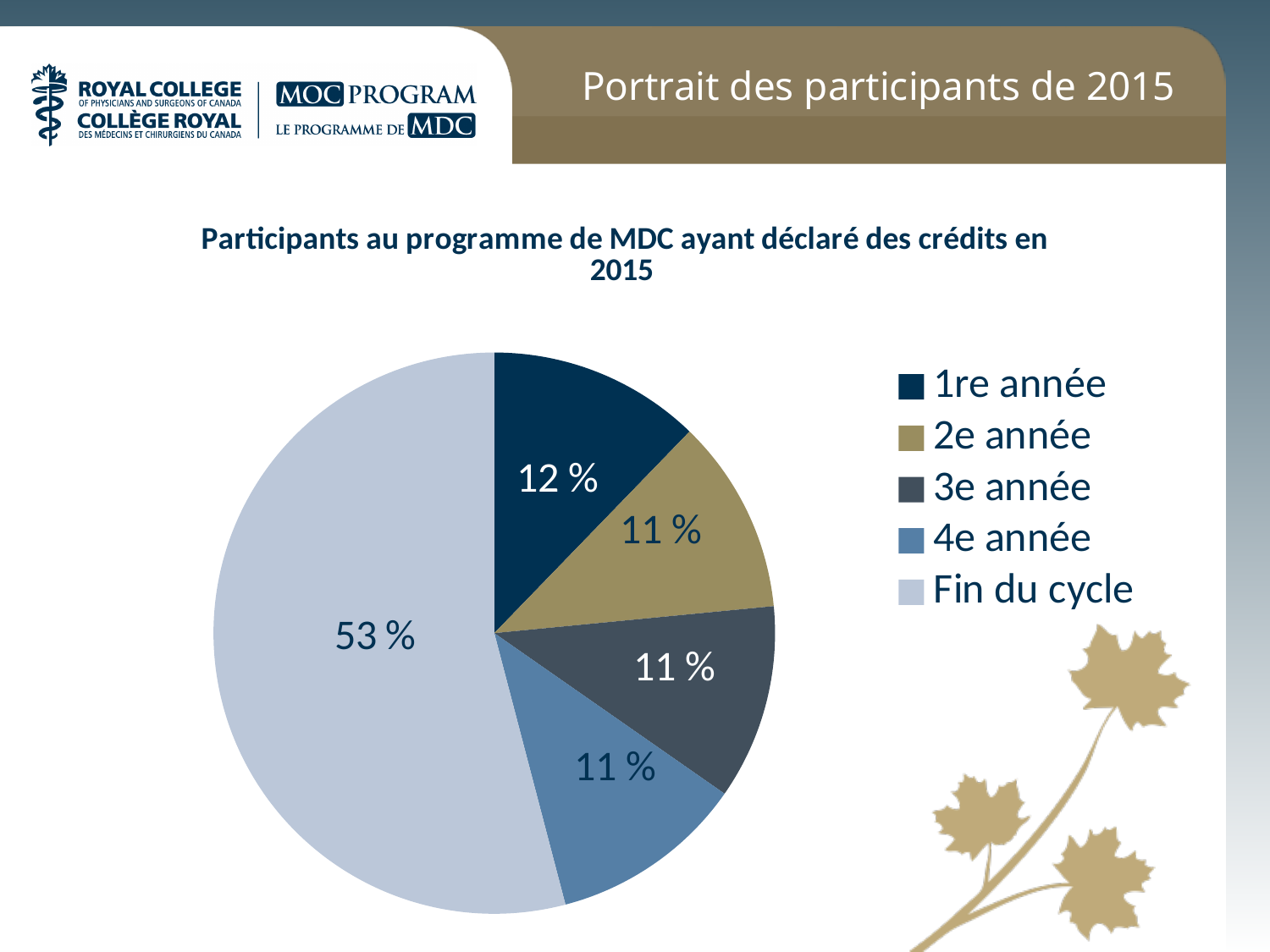
Is the share for "Fin du cycle" greater or less than 50 %? greater What is the value shown for "4e année"? 11 % What is the title of the chart? Participants au programme de MDC ayant déclaré des crédits en 2015 Which category has the largest slice of the pie? Fin du cycle Which is larger, the share for "1re année" or the share for "3e année"? 1re année How many entries does the legend list? 5 How many slices does the pie chart have? 5 What is the value shown for "2e année"? 11 % What is the difference between the shares for "Fin du cycle" and "1re année"? 41 % What kind of chart is shown on the slide? pie chart What share of the pie does "1re année" represent? 12 % What share of the pie does "Fin du cycle" represent? 53 %